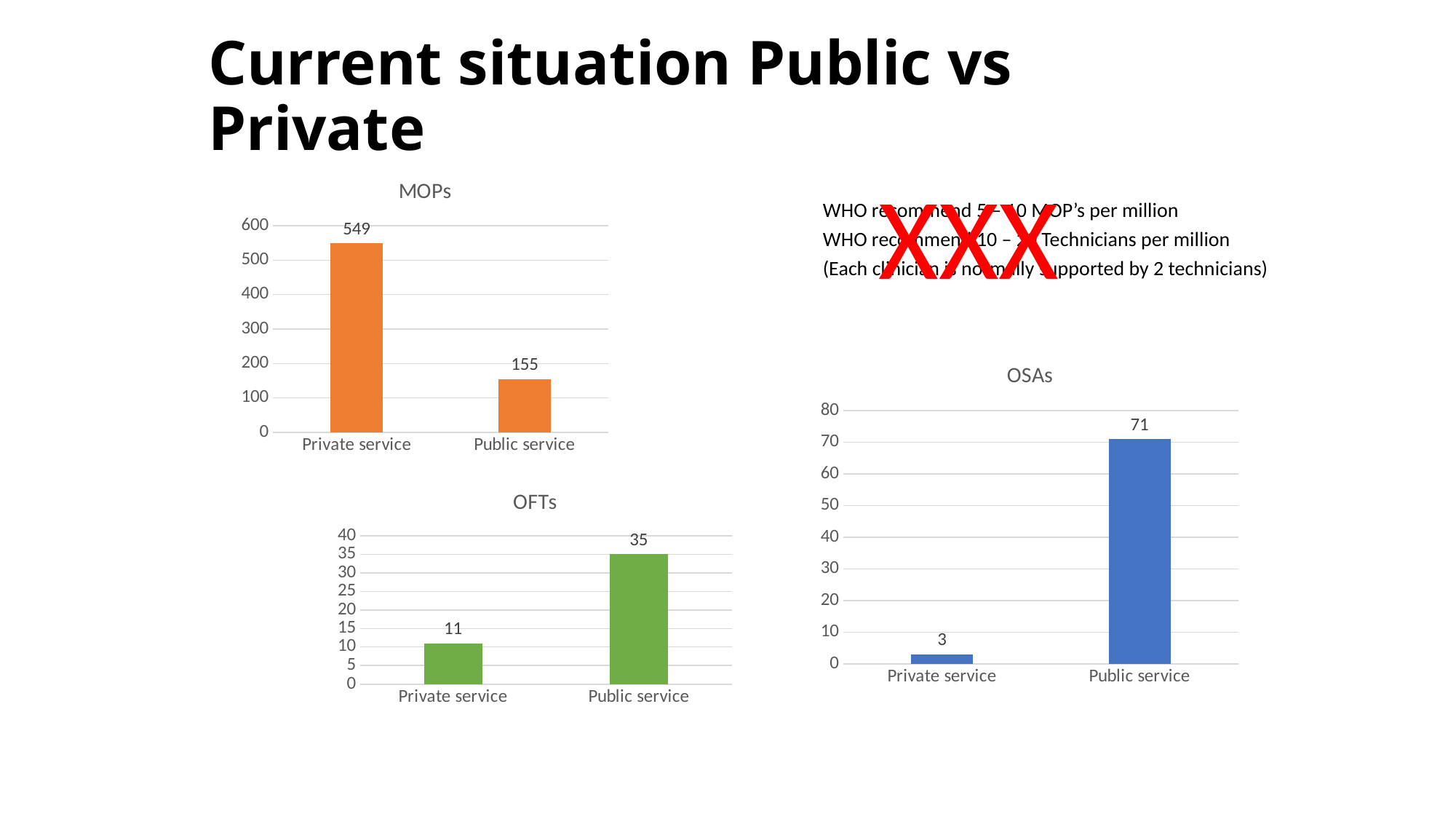
In the OFTs chart, what is the difference between Public service and Private service? 24 What kind of chart is the OSAs chart? bar chart What colour are the bars in the OFTs chart? green In the OFTs chart, which category has the highest value? Public service In the MOPs chart, what is the value for Private service? 549 In the OSAs chart, which category has the lowest value? Private service How many categories does the MOPs chart show? 2 In the OFTs chart, what is the value for Private service? 11 In the MOPs chart, what is the value for Public service? 155 In the OSAs chart, is the value for Private service larger or smaller than the value for Public service? smaller In the MOPs chart, what is the difference between Private service and Public service? 394 In the OSAs chart, what is the value for Public service? 71